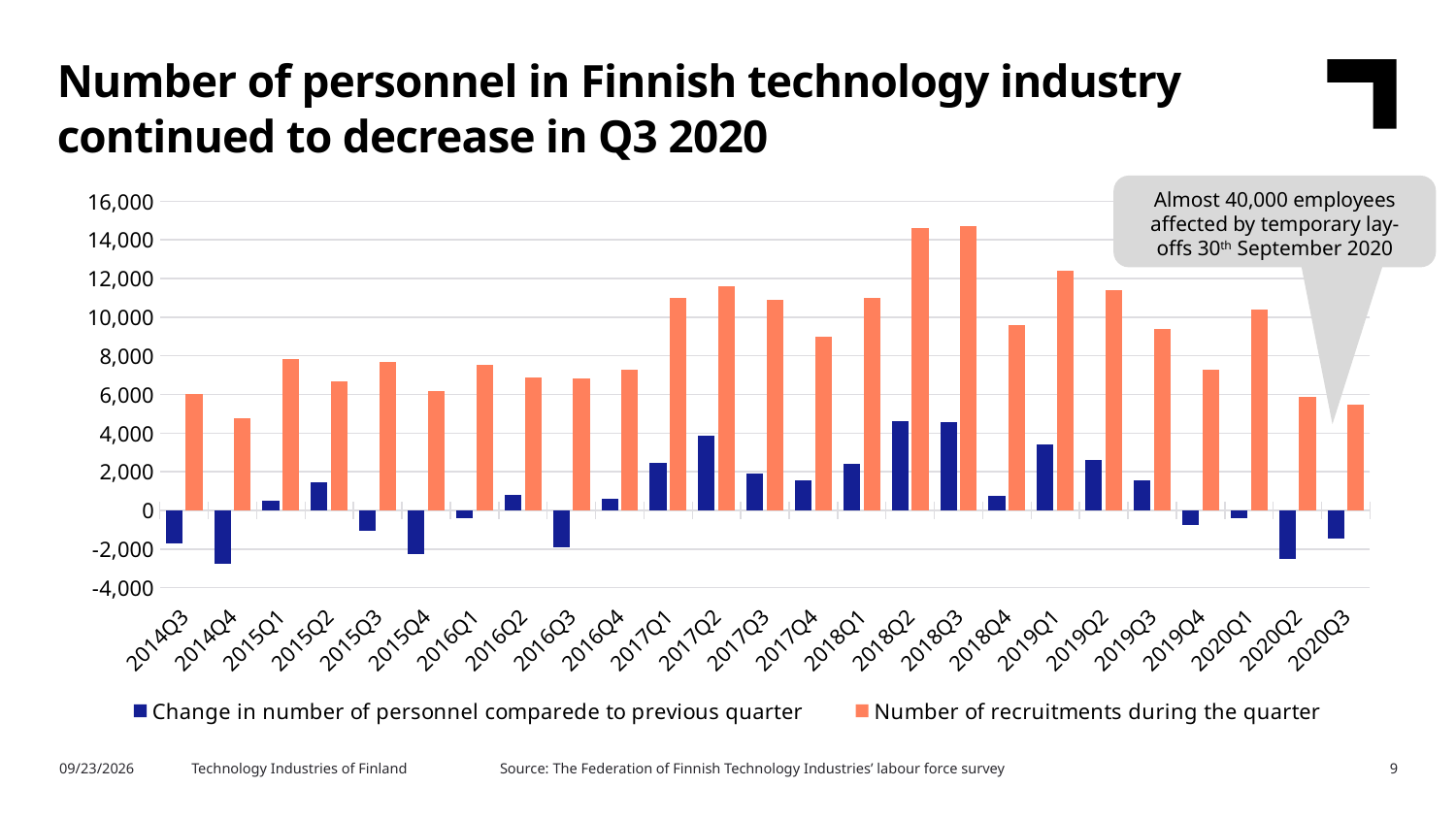
What kind of chart is shown on the slide? Bar chart Which quarter had a larger change in number of personnel compared to previous quarter, 2017Q1 or 2020Q3? 2017Q1 According to the callout on the chart, about how many employees were affected by temporary lay-offs on 30th September 2020? Almost 40,000 Is the number of recruitments during the quarter for 2020Q3 greater or less than 6,000? less How many series does the legend list? 2 Which quarter had more recruitments during the quarter, 2018Q2 or 2016Q1? 2018Q2 Is the change in number of personnel compared to previous quarter for 2017Q2 greater or less than 2,000? greater Is the number of recruitments during the quarter for 2018Q2 greater or less than 14,000? greater Do the number of recruitments during the quarter rise or fall from 2019Q1 to 2020Q3? fall How many quarters are shown on the x axis? 25